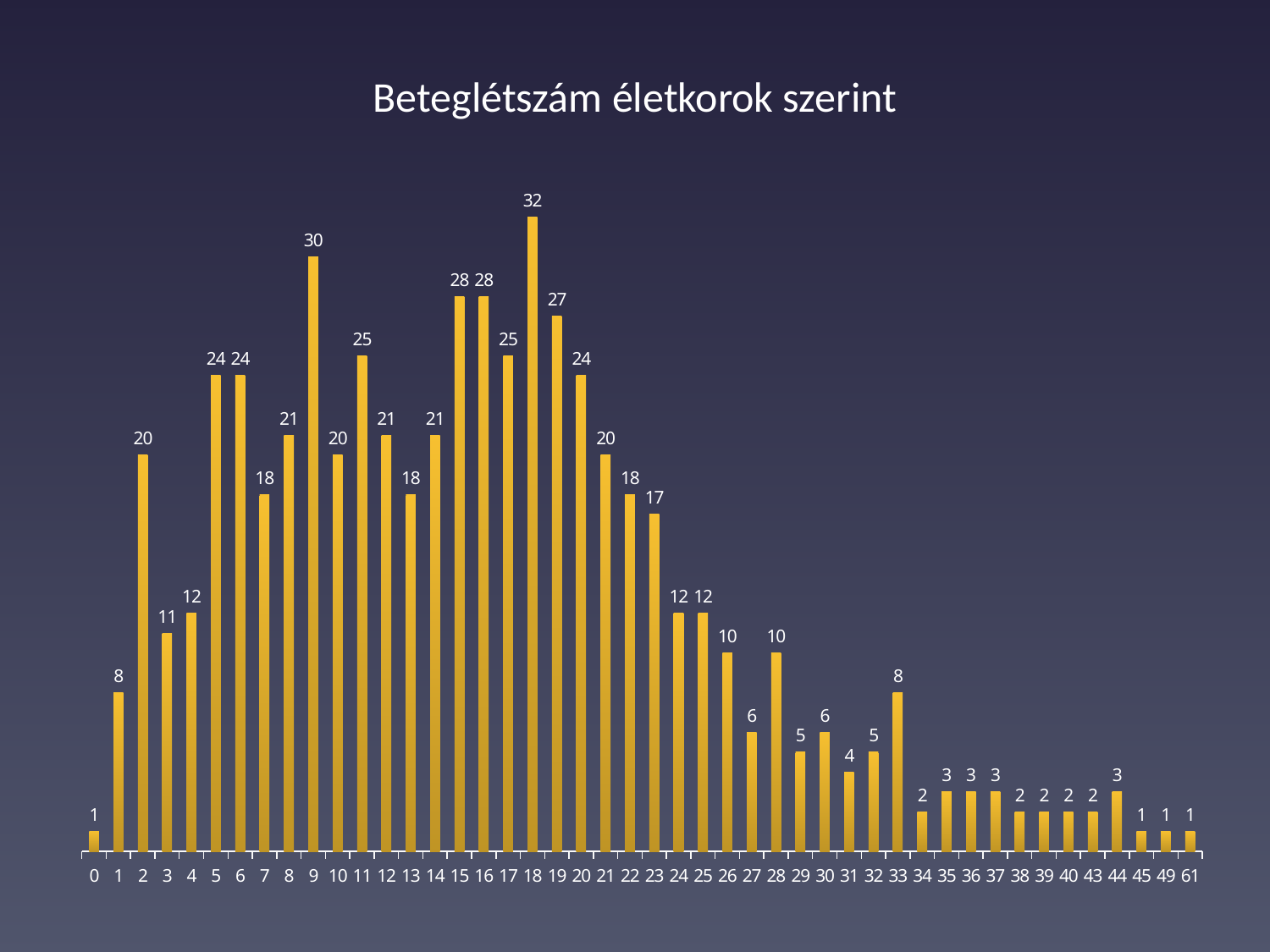
What is the value for age 9? 30 What is the value for age 33? 8 What kind of chart is shown on the slide? bar chart What is the value for age 2? 20 Which has a larger value, age 19 or age 20? 19 Which age has the highest number of patients? 18 Do the values rise or fall from age 18 to age 26? fall What is the difference between the values for age 18 and age 9? 2 What is the difference between the values for age 1 and age 0? 7 What is the value for age 61? 1 Which has a larger value, age 27 or age 28? 28 How many age categories are shown on the x axis? 46